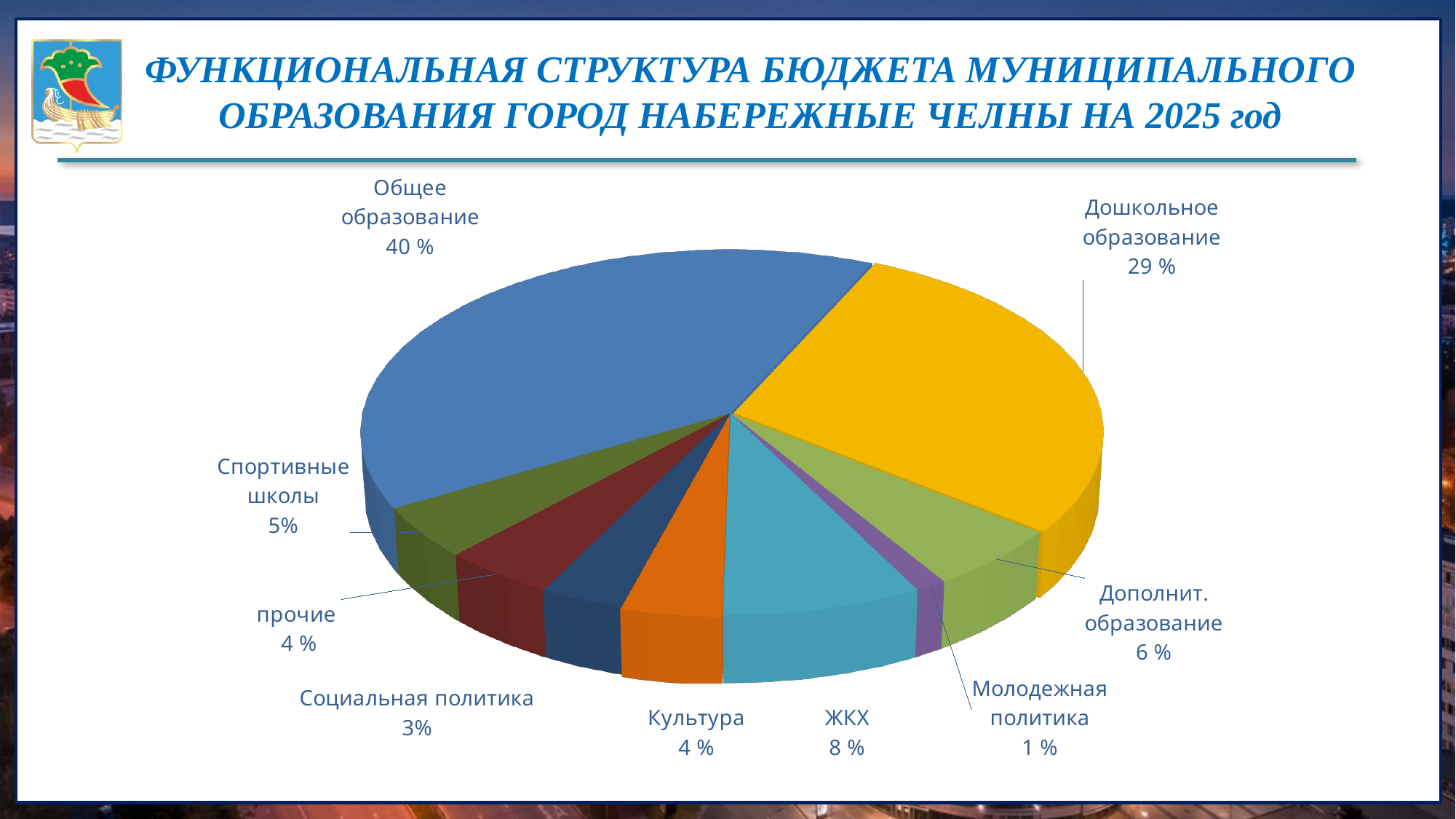
How many slices does the pie chart have? 9 What is the value shown for Молодежная политика? 1 % What colour is the slice for Дошкольное образование? yellow What share of the budget goes to Общее образование? 40 % What is the value shown for Спортивные школы? 5% What share of the budget goes to Дошкольное образование? 29 % Which category has the largest share of the pie? Общее образование What kind of chart is shown on the slide? pie chart Which is larger, the share for ЖКХ or the share for Дополнит. образование? ЖКХ Which category has the smallest share of the pie? Молодежная политика What is the difference in percentage points between Общее образование and Дошкольное образование? 11 What is the value shown for ЖКХ? 8 %